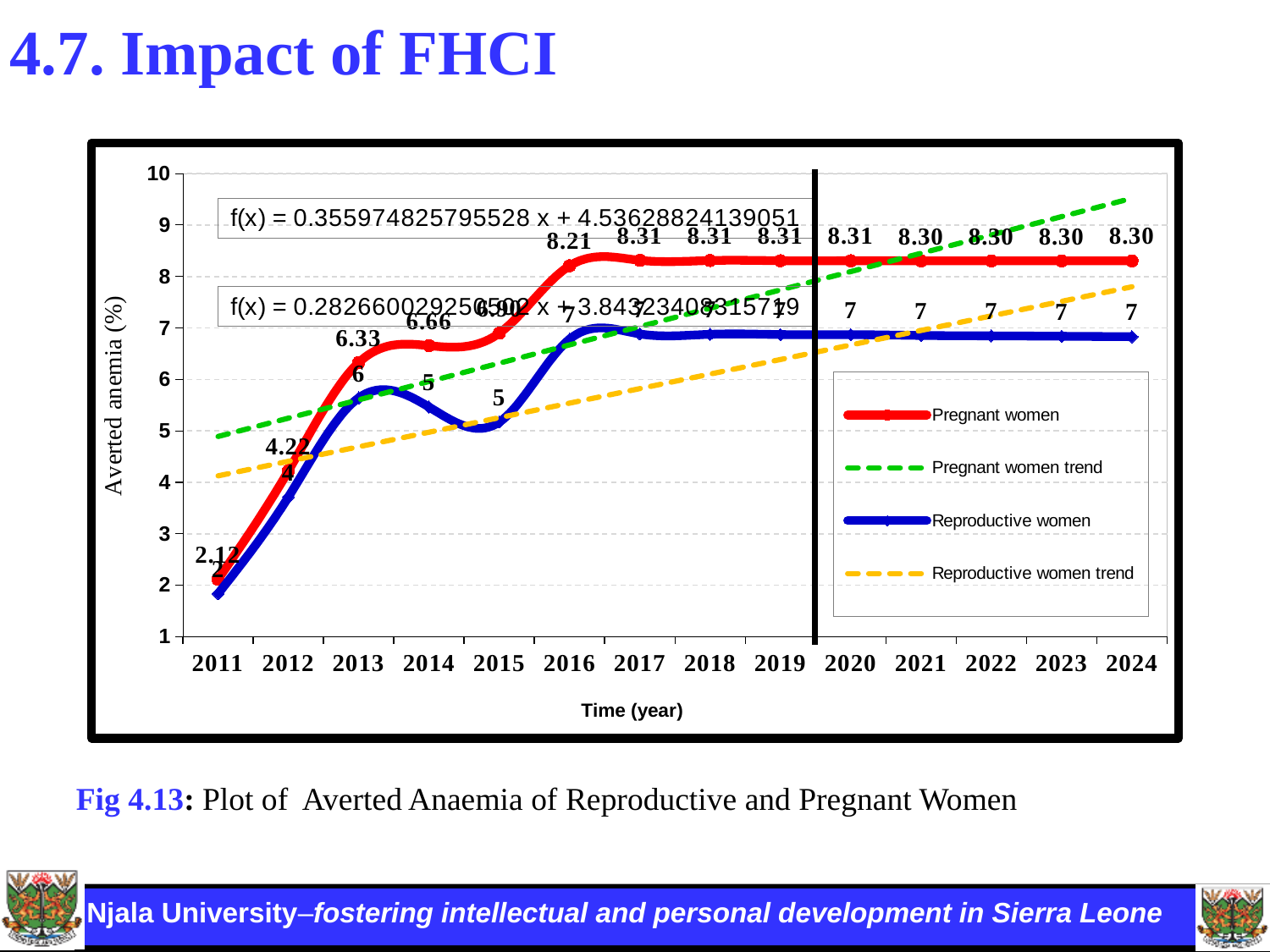
In 2013, which series has the larger value, Pregnant women or Reproductive women? Pregnant women What is the difference between the Pregnant women values in 2013 and 2012? 2.11 What is the value for Pregnant women in 2011? 2.12 What is the value for Pregnant women in 2013? 6.33 What is the value for Reproductive women in 2014? 5 How many years are shown on the x axis? 14 What kind of chart is shown on the slide? Line chart In which year is the Pregnant women value lowest? 2011 What is the value for Pregnant women in 2016? 8.21 How many entries does the legend list? 4 What is the value for Pregnant women in 2024? 8.30 What is the value for Reproductive women in 2012? 4